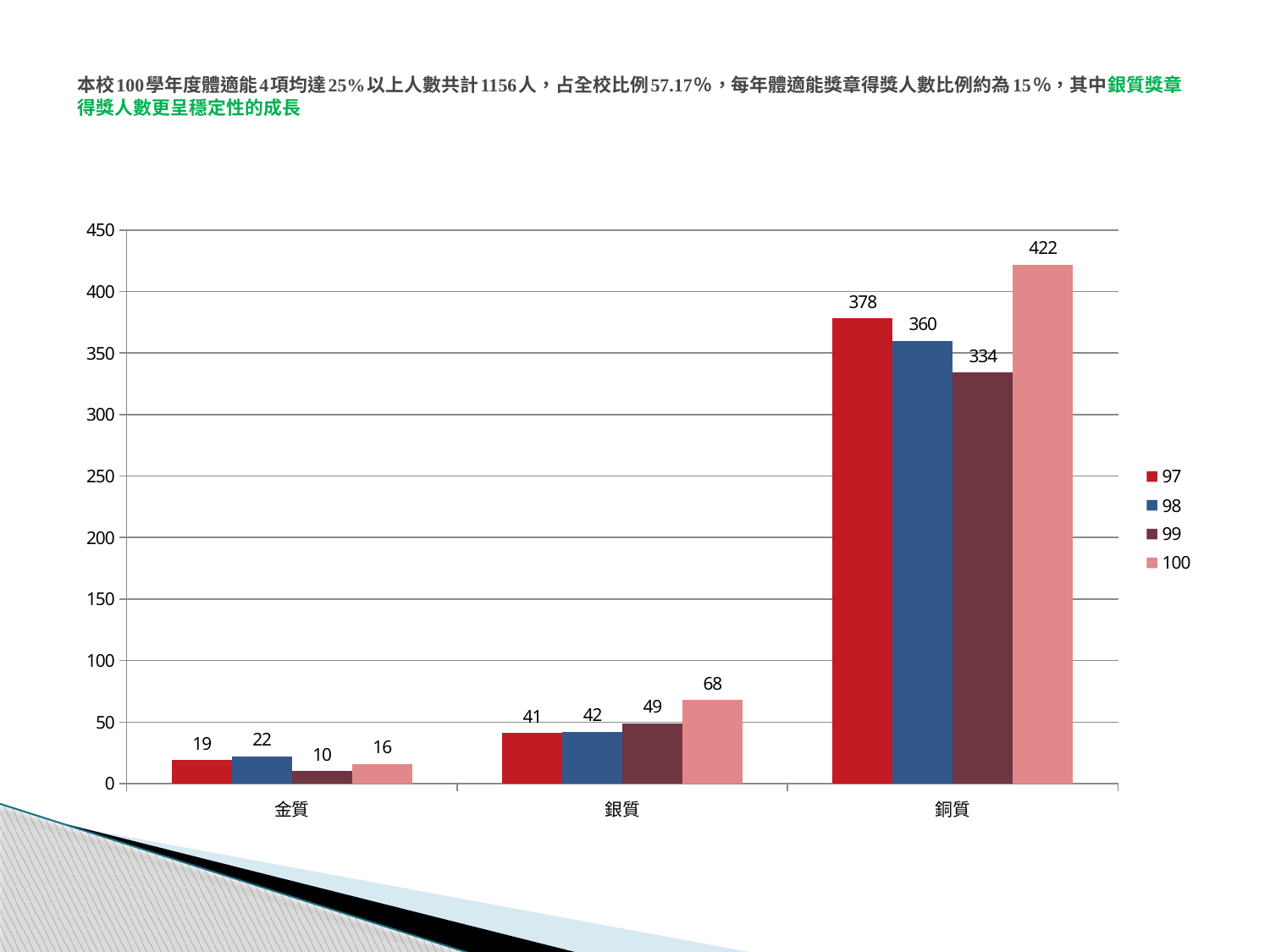
Which is larger for 銀質: the value for 99 or the value for 100? 100 What is the difference between the 100 and 99 values for 銅質? 88 How many categories are shown on the x axis? 3 Which category has the highest value in series 98? 銅質 What is the value for 銀質 in series 97? 41 Is the value for 銅質 in series 97 greater or less than 350? greater What kind of chart is shown on the slide? bar chart What is the value for 金質 in series 99? 10 What is the value for 銅質 in series 100? 422 Which series has the lowest value for 金質? 99 Do the values for 銀質 rise or fall from series 97 to series 100? rise How many series does the legend list? 4